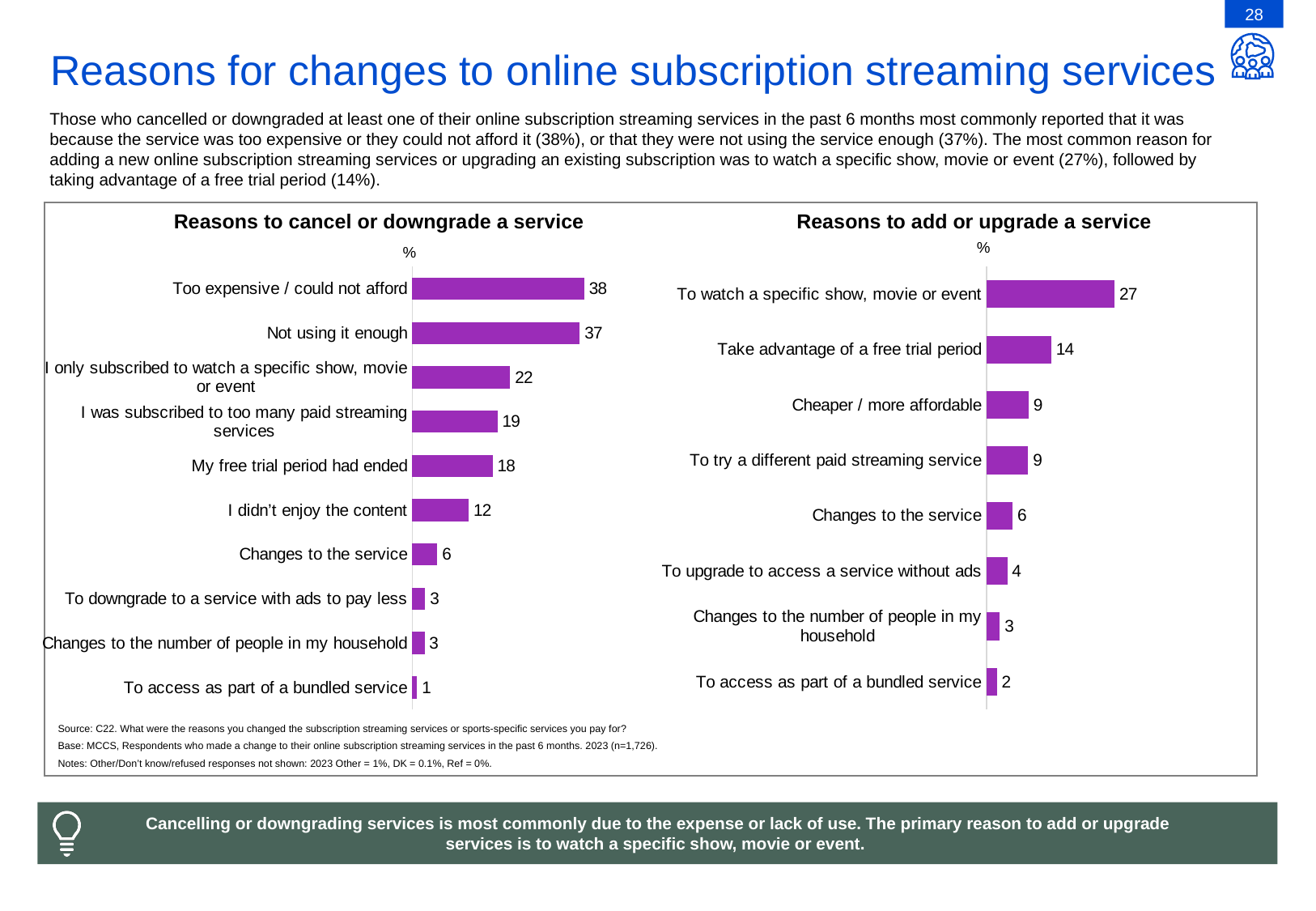
In the 'Reasons to cancel or downgrade a service' chart, which reason has the highest value? Too expensive / could not afford What type of chart is the 'Reasons to add or upgrade a service' chart? Bar chart In the 'Reasons to cancel or downgrade a service' chart, what is the difference between 'Not using it enough' and 'My free trial period had ended'? 19 In the 'Reasons to add or upgrade a service' chart, which is larger: 'Changes to the service' or 'To upgrade to access a service without ads'? Changes to the service What is the title of the chart on the left side of the slide? Reasons to cancel or downgrade a service In the 'Reasons to cancel or downgrade a service' chart, which is larger: 'I didn't enjoy the content' or 'Changes to the service'? I didn't enjoy the content How many reasons are shown in the 'Reasons to cancel or downgrade a service' chart? 10 In the 'Reasons to cancel or downgrade a service' chart, what is the value for 'Too expensive / could not afford'? 38 How many reasons are shown in the 'Reasons to add or upgrade a service' chart? 8 In the 'Reasons to add or upgrade a service' chart, what is the difference between 'To watch a specific show, movie or event' and 'Cheaper / more affordable'? 18 In the 'Reasons to add or upgrade a service' chart, what is the value for 'Take advantage of a free trial period'? 14 In the 'Reasons to add or upgrade a service' chart, which reason has the lowest value? To access as part of a bundled service